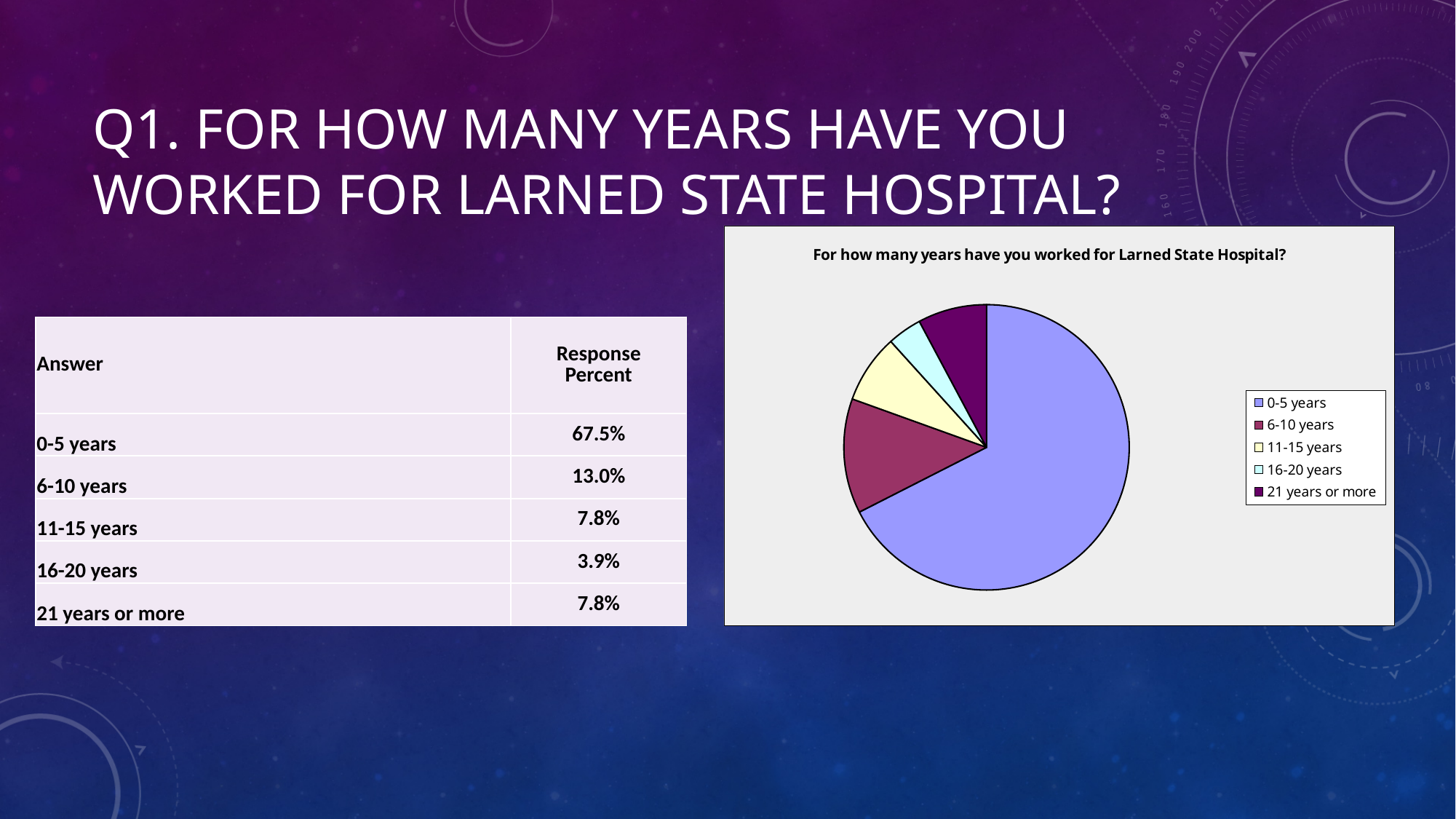
What kind of chart is shown on the slide? pie chart Which category has the largest share of the pie? 0-5 years What is the chart's title? For how many years have you worked for Larned State Hospital? What is the response percent for 21 years or more? 7.8% Which category has the smallest share of the pie? 16-20 years What is the response percent for 6-10 years? 13.0% What is the response percent for 16-20 years? 3.9% How many categories does the legend of the pie chart list? 5 What is the response percent for 0-5 years? 67.5% What is the difference in response percent between 0-5 years and 6-10 years? 54.5% Which is larger, the share for 6-10 years or the share for 11-15 years? 6-10 years What colour is the slice for 0-5 years in the pie chart? light blue/periwinkle